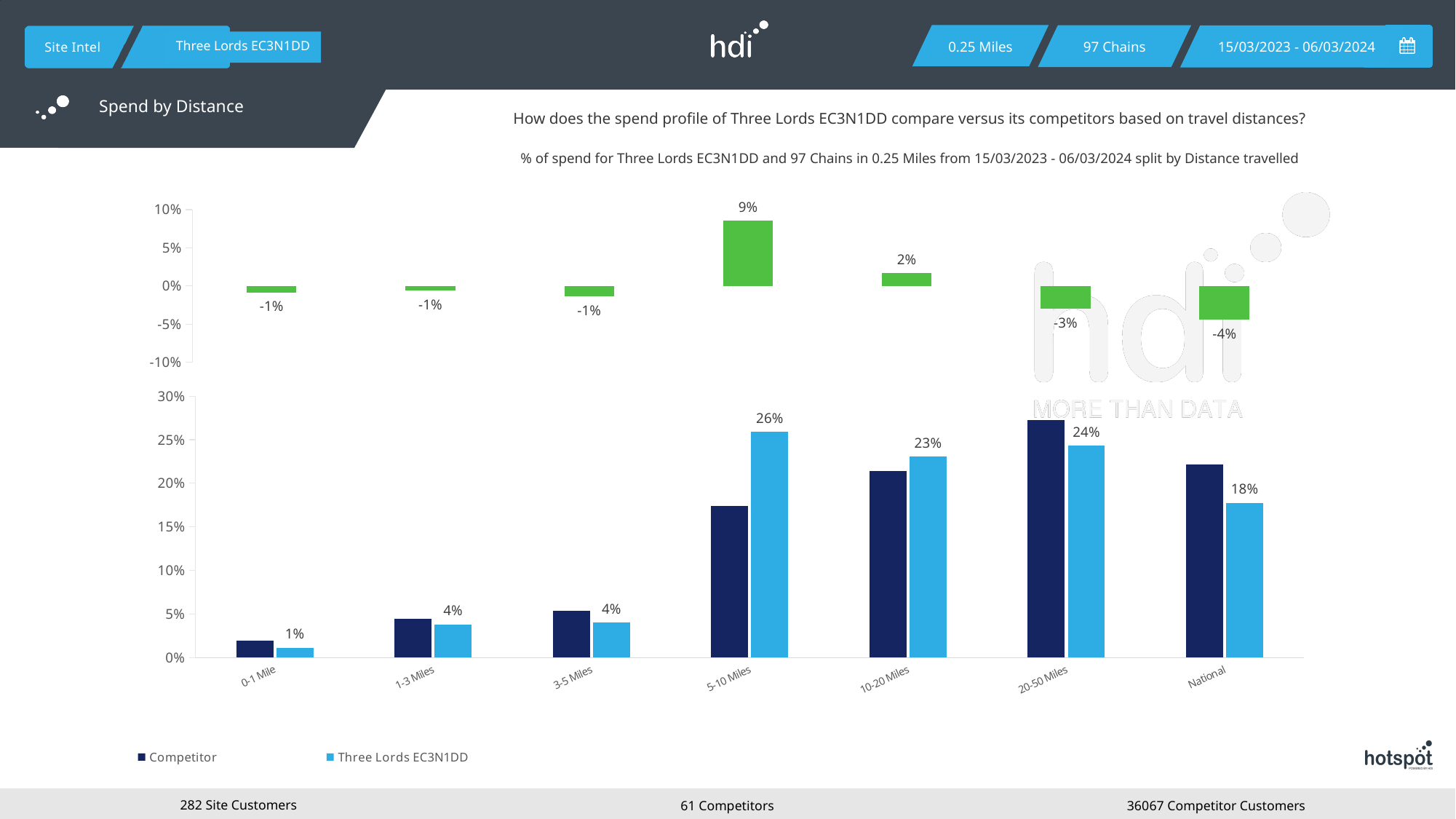
How many series does the legend of the bottom chart list? 2 In the bottom chart, what is the value for Three Lords EC3N1DD in the National category? 18% How many distance categories are shown on the x axis of the bottom chart? 7 In the bottom chart, what is the value for Three Lords EC3N1DD in the 5-10 Miles category? 26% In the bottom chart, is the Competitor value for 5-10 Miles greater or less than 20%? less What kind of chart is the bottom chart? Bar chart In the bottom chart, for the 20-50 Miles category, which series has the larger value: Competitor or Three Lords EC3N1DD? Competitor In the top chart, what is the value shown for the 5-10 Miles category? 9% In the top chart, what is the value shown for the 10-20 Miles category? 2% In the top chart, which category has the lowest value? National In the bottom chart, what is the difference between the Three Lords EC3N1DD values for 5-10 Miles and National? 8 percentage points In the bottom chart, which distance category has the highest value for Three Lords EC3N1DD? 5-10 Miles